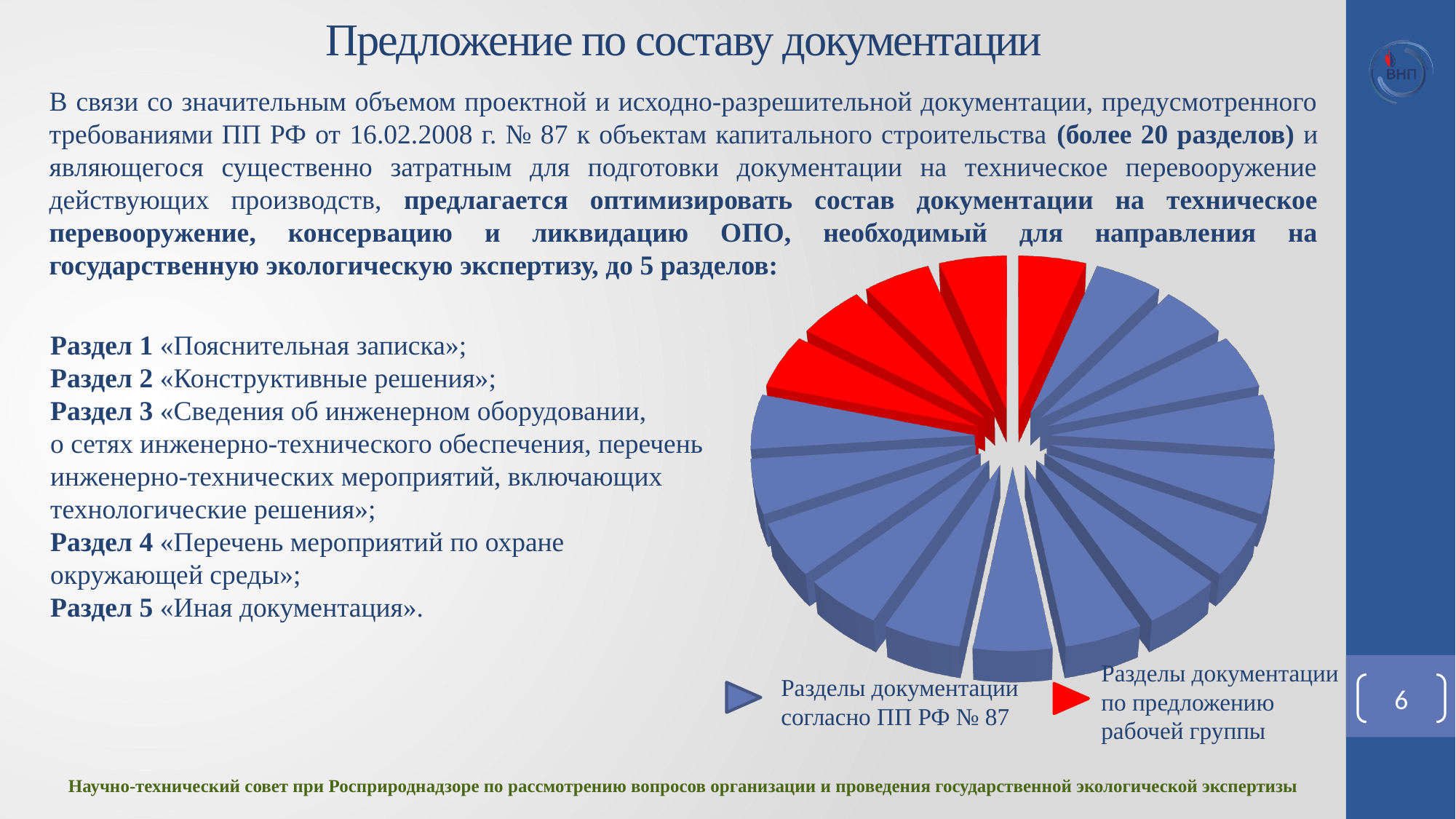
Which group takes up the smaller share of the pie? Разделы документации по предложению рабочей группы Are the red slices more or less than half of the pie? less Which colour represents «Разделы документации согласно ПП РФ № 87» in the chart? blue How many entries does the chart legend list? 2 Which colour represents «Разделы документации по предложению рабочей группы» in the chart? red What kind of chart is shown on the slide? pie chart Which group takes up the larger share of the pie: «Разделы документации согласно ПП РФ № 87» or «Разделы документации по предложению рабочей группы»? Разделы документации согласно ПП РФ № 87 How many red slices are there in the pie chart? 5